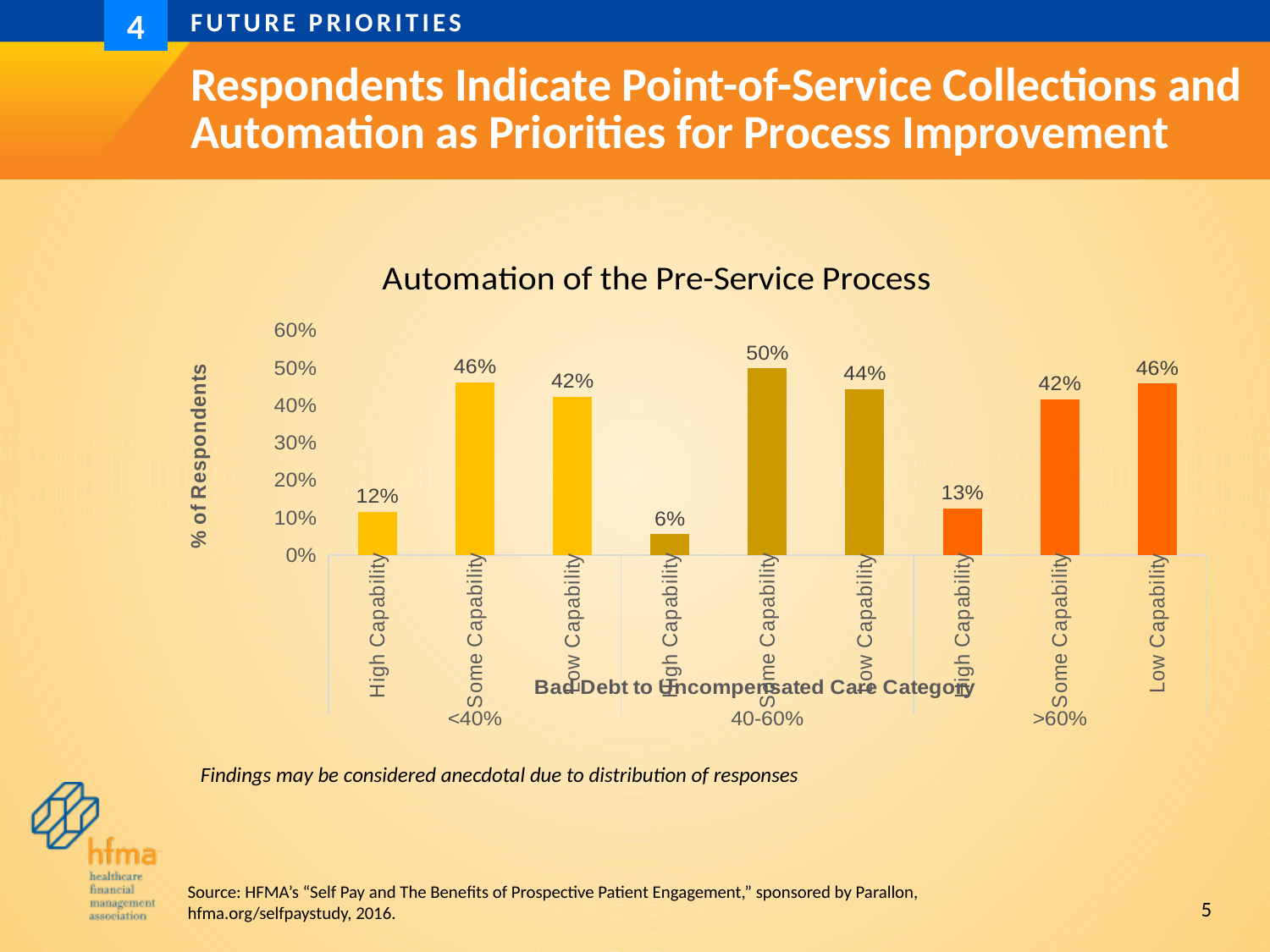
How many bars are plotted on the chart? 9 Which bar has the lowest value on the chart? High Capability, 40-60% What is the value for Low Capability in the >60% bad debt category? 46% What is the title of the chart? Automation of the Pre-Service Process What type of chart is shown on the slide? Bar chart What is the difference between Some Capability and High Capability in the 40-60% category? 44% What is the label of the vertical axis? % of Respondents What is the value for High Capability in the <40% bad debt category? 12% What is the value for Some Capability in the 40-60% bad debt category? 50% Which is larger: Some Capability in the <40% category or Some Capability in the >60% category? Some Capability in the <40% category What is the difference between Low Capability and High Capability in the >60% category? 33% Which bar has the highest value on the chart? Some Capability, 40-60%